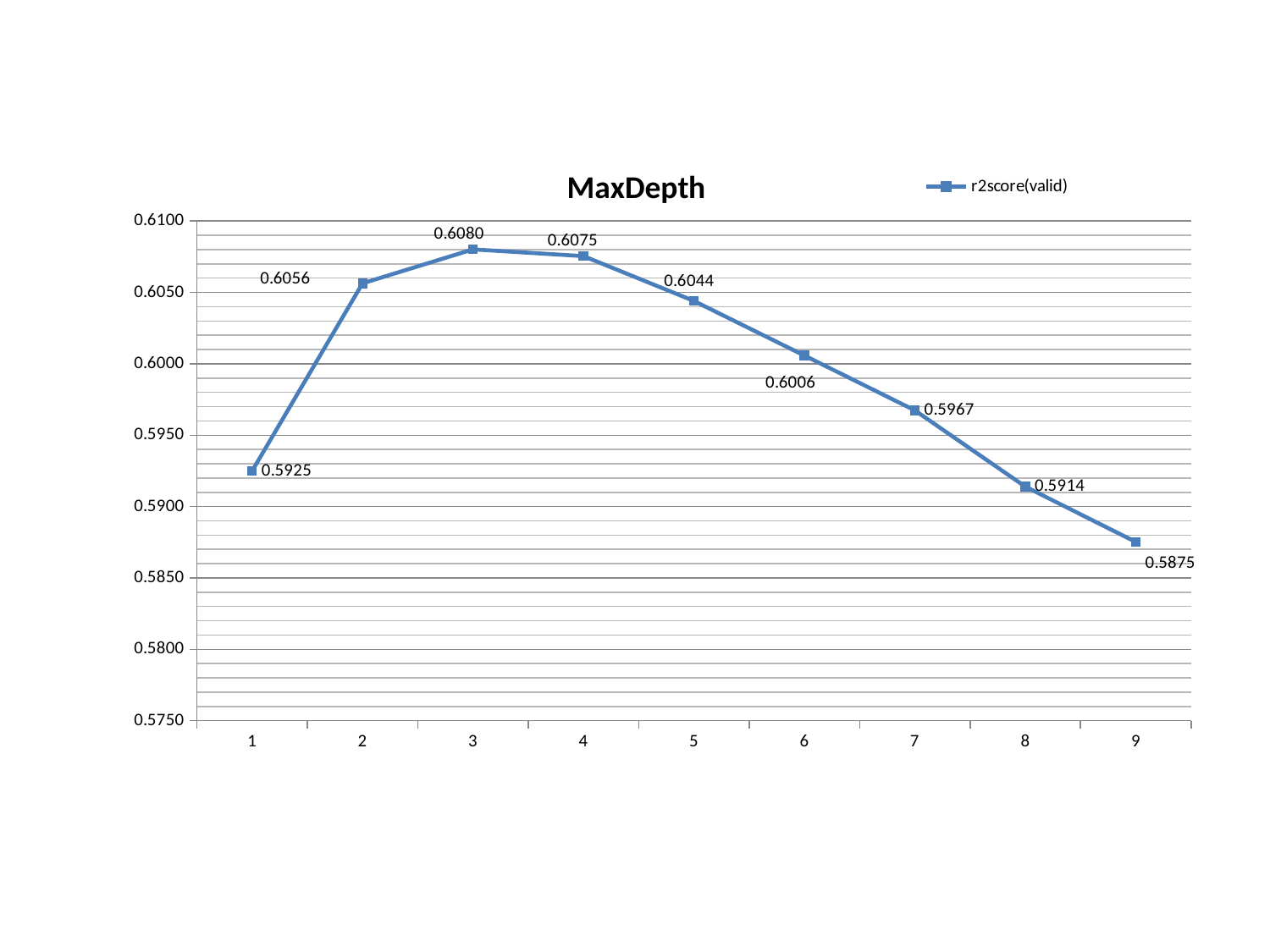
How many series does the legend list? 1 Which has a higher r2score(valid): MaxDepth 2 or MaxDepth 7? MaxDepth 2 What is the r2score(valid) value at MaxDepth 1? 0.5925 At which MaxDepth is the r2score(valid) highest? 3 What is the difference between the r2score(valid) at MaxDepth 3 and at MaxDepth 9? 0.0205 Is the r2score(valid) at MaxDepth 6 greater or less than 0.6000? greater What is the r2score(valid) value at MaxDepth 9? 0.5875 How many MaxDepth values are plotted on the chart? 9 At which MaxDepth is the r2score(valid) lowest? 9 What kind of chart is shown on the slide? line chart What is the title of the chart? MaxDepth What is the r2score(valid) value at MaxDepth 3? 0.6080